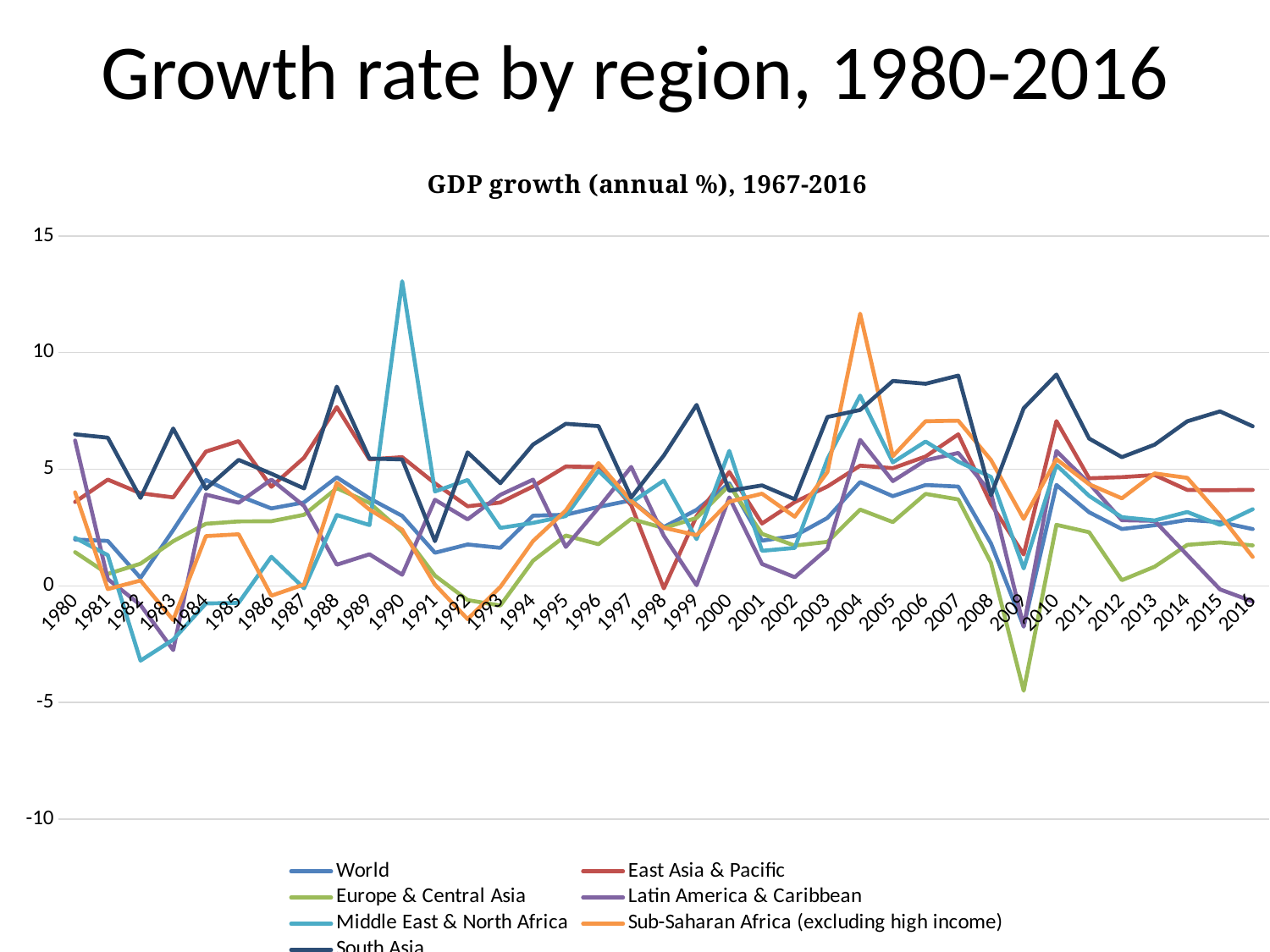
What kind of chart is shown on the slide? line chart Is the value for South Asia in 2010 greater or less than 5? greater Which region has the highest value in 2016? South Asia Is the value for Sub-Saharan Africa (excluding high income) in 2004 greater or less than 10? greater What is the title printed above the chart? GDP growth (annual %), 1967-2016 How many series does the legend list? 7 In 2010, which is larger: the value for South Asia or the value for World? South Asia Is the value for Europe & Central Asia in 2009 greater or less than 0? less Which region has the lowest value in 2009? Europe & Central Asia Which region has the highest value in 1990? Middle East & North Africa How many years are plotted along the x axis? 37